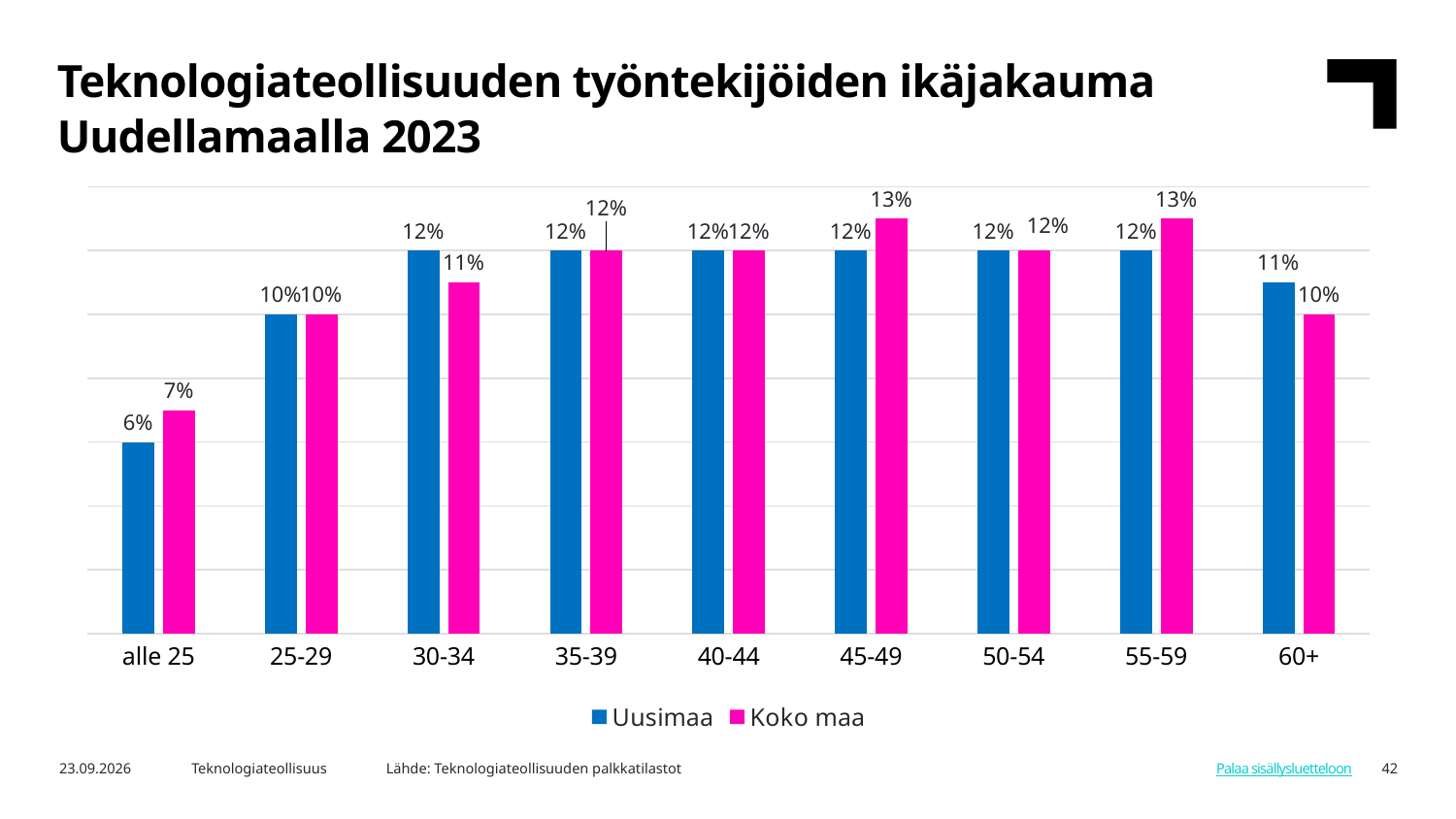
What is the Koko maa value for the '30-34' age group? 11% What is the Uusimaa value for the 'alle 25' age group? 6% What type of chart is shown on the slide? Bar chart Which age group has the lowest Uusimaa value? alle 25 What is the difference between the Uusimaa and Koko maa values for the '60+' age group? 1 percentage point How many age categories are shown on the x axis? 9 Which age group has the lowest Koko maa value? alle 25 What is the Uusimaa value for the '60+' age group? 11% What is the Koko maa value for the '45-49' age group? 13% Which series is shown in pink in the legend? Koko maa How many series does the legend list? 2 For the 'alle 25' age group, which is larger: Uusimaa or Koko maa? Koko maa